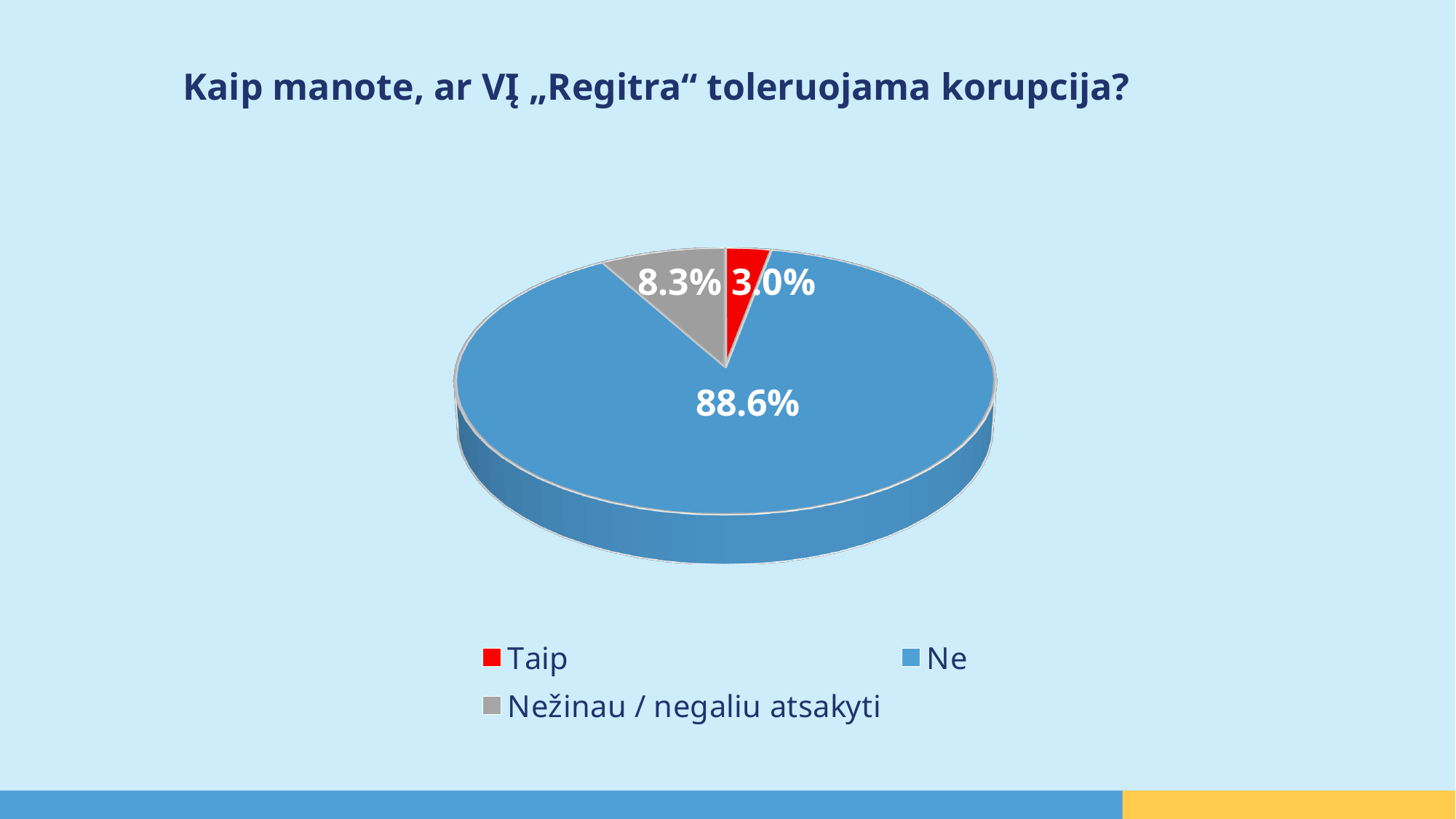
Which answer has the largest share of the pie? Ne How many slices does the pie chart have? 3 What is the difference in percentage points between the "Ne" and "Taip" shares? 85.6 Which is larger, the share for "Taip" or the share for "Nežinau / negaliu atsakyti"? Nežinau / negaliu atsakyti What colour is the slice for "Taip"? Red Which answer has the smallest share of the pie? Taip What share of respondents answered "Nežinau / negaliu atsakyti"? 8.3% What kind of chart is shown on the slide? Pie chart What share of respondents answered "Ne"? 88.6% What is the title of the chart? Kaip manote, ar VĮ „Regitra“ toleruojama korupcija? What is the difference in percentage points between the "Nežinau / negaliu atsakyti" and "Taip" shares? 5.3 What share of respondents answered "Taip"? 3.0%